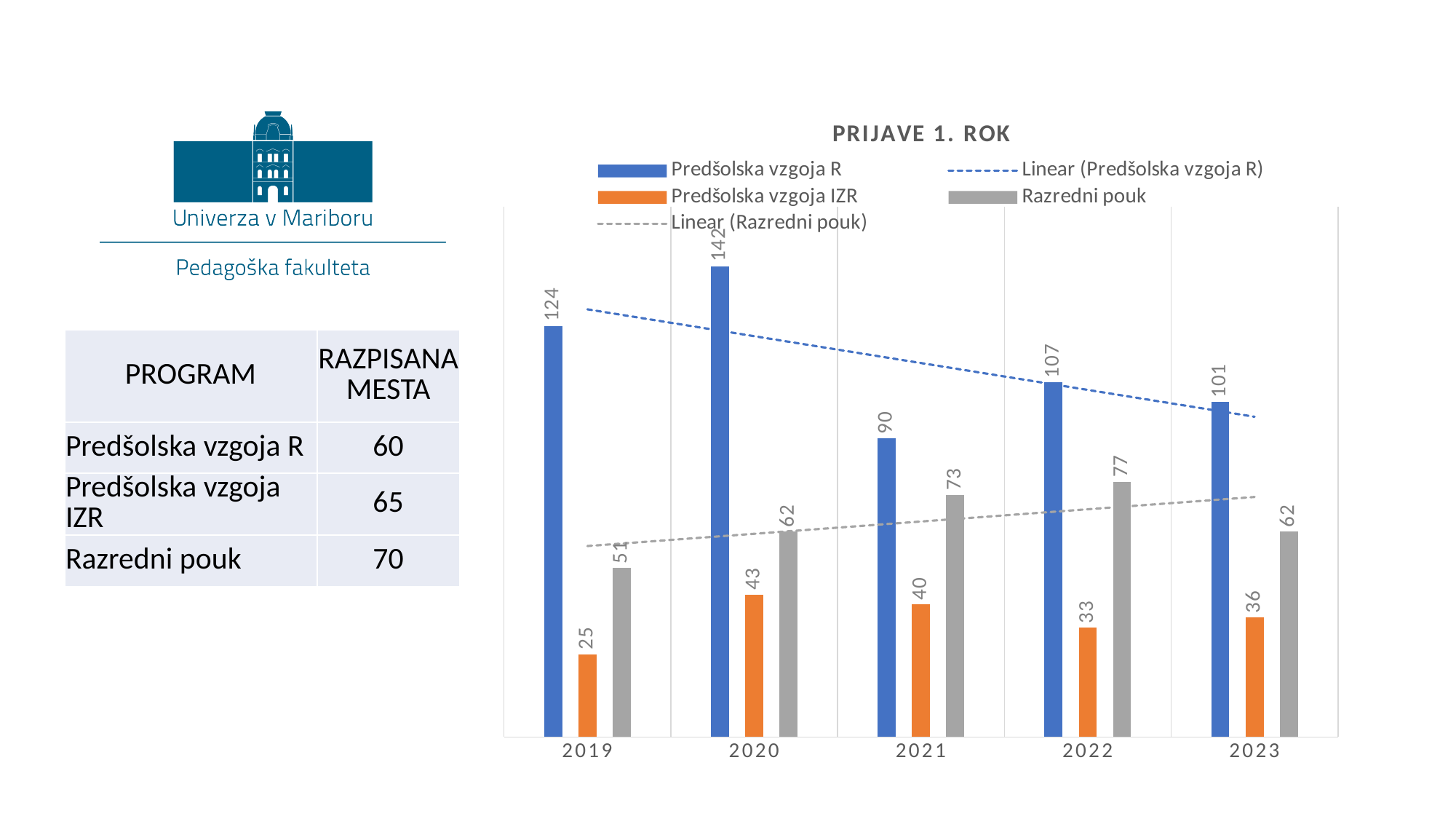
Which is larger in 2021: Predšolska vzgoja IZR or Razredni pouk? Razredni pouk Does the Razredni pouk value rise or fall from 2019 to 2022? rise What is the title of the chart? PRIJAVE 1. ROK What is the value for Predšolska vzgoja IZR in 2019? 25 In which year is Predšolska vzgoja IZR lowest? 2019 In which year is Predšolska vzgoja R highest? 2020 How many years are shown on the x axis? 5 What is the value for Razredni pouk in 2022? 77 How many entries does the legend list? 5 What kind of chart is this? bar chart What is the difference between Predšolska vzgoja R and Razredni pouk in 2023? 39 What is the value for Predšolska vzgoja R in 2020? 142